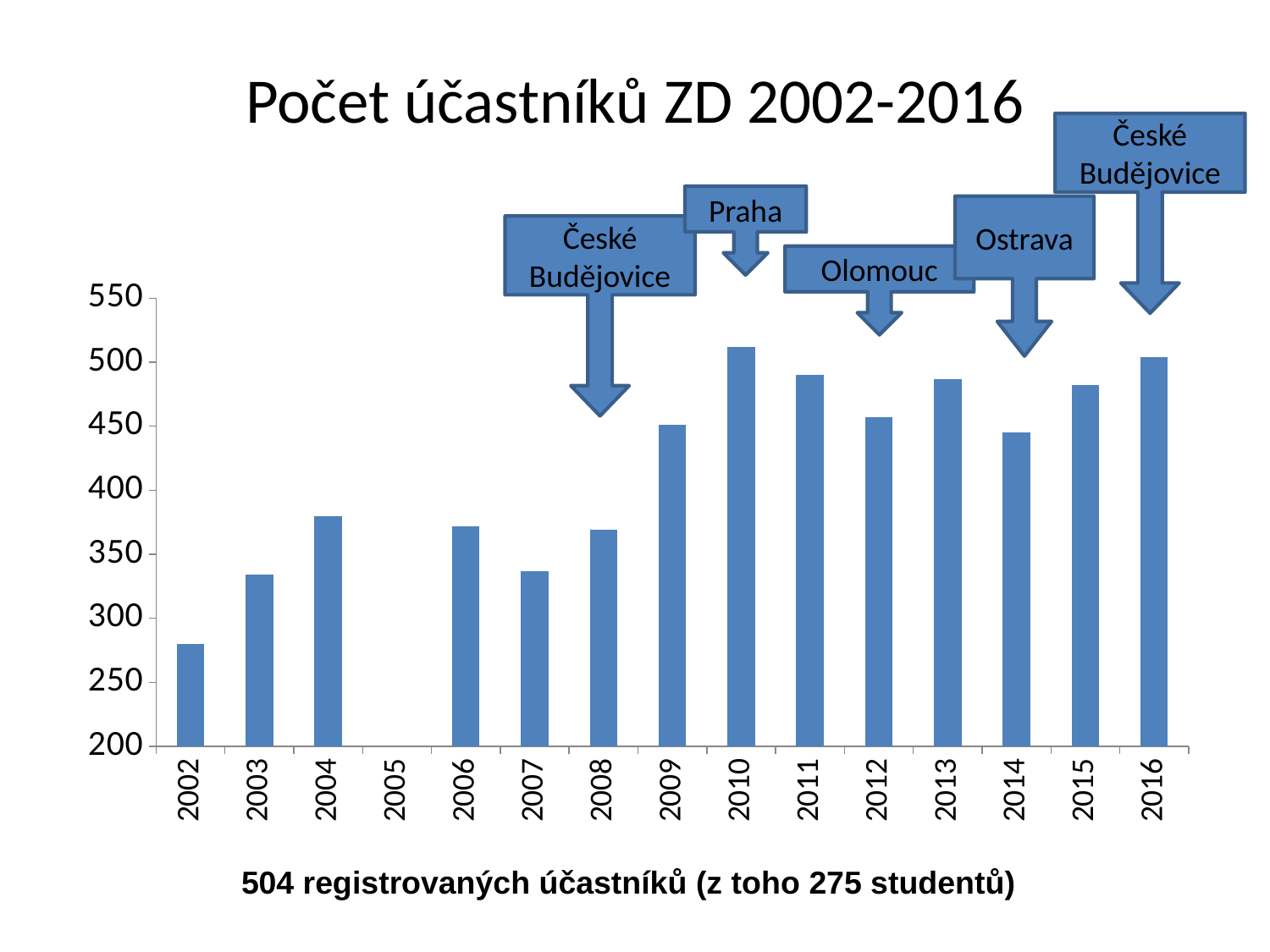
Is the value for 2004 greater or less than 400? less Is the value for 2002 greater or less than 300? less Which is larger, the value for 2012 or the value for 2013? 2013 Which year has the highest bar in the chart? 2010 Do the values generally rise or fall from 2002 to 2016? rise Which is larger, the value for 2009 or the value for 2011? 2011 Is the value for 2008 greater or less than 350? greater How many years are labelled on the x axis of the chart? 15 What is the title of the chart? Počet účastníků ZD 2002-2016 What kind of chart is shown on the slide? bar chart According to the text below the chart, how many registered participants were there in 2016? 504